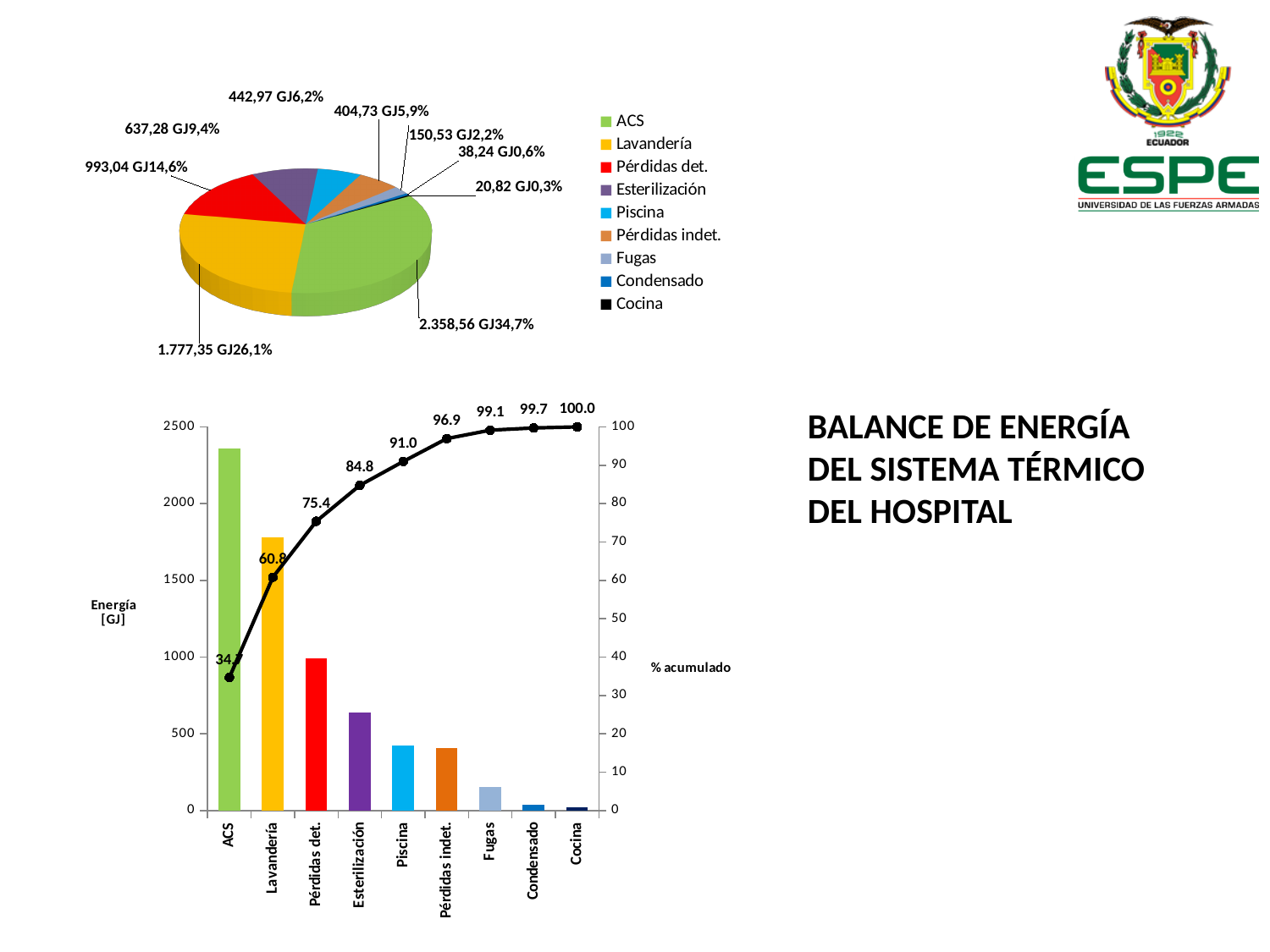
In the top pie chart, what percentage is shown for the smallest slice, 20,82 GJ? 0,3% In the top pie chart, what share of the total does the ACS slice represent? 34,7% In the bottom chart, does the cumulative percentage line rise or fall from left to right? rise In the bottom chart, what is the cumulative percentage (% acumulado) at Pérdidas det.? 75.4 How many entries does the legend of the top pie chart list? 9 In the bottom chart, what is the cumulative percentage at Piscina? 91.0 In the bottom chart, is the energy value for the ACS bar greater or less than 2000? greater What type of chart is the top chart on the slide? pie chart In the bottom chart, how many categories are shown on the x axis? 9 In the bottom chart, is the energy value for the Esterilización bar greater or less than 500? greater In the top pie chart, which category has the largest slice? ACS In the top pie chart, what value is shown for the Lavandería slice? 1.777,35 GJ